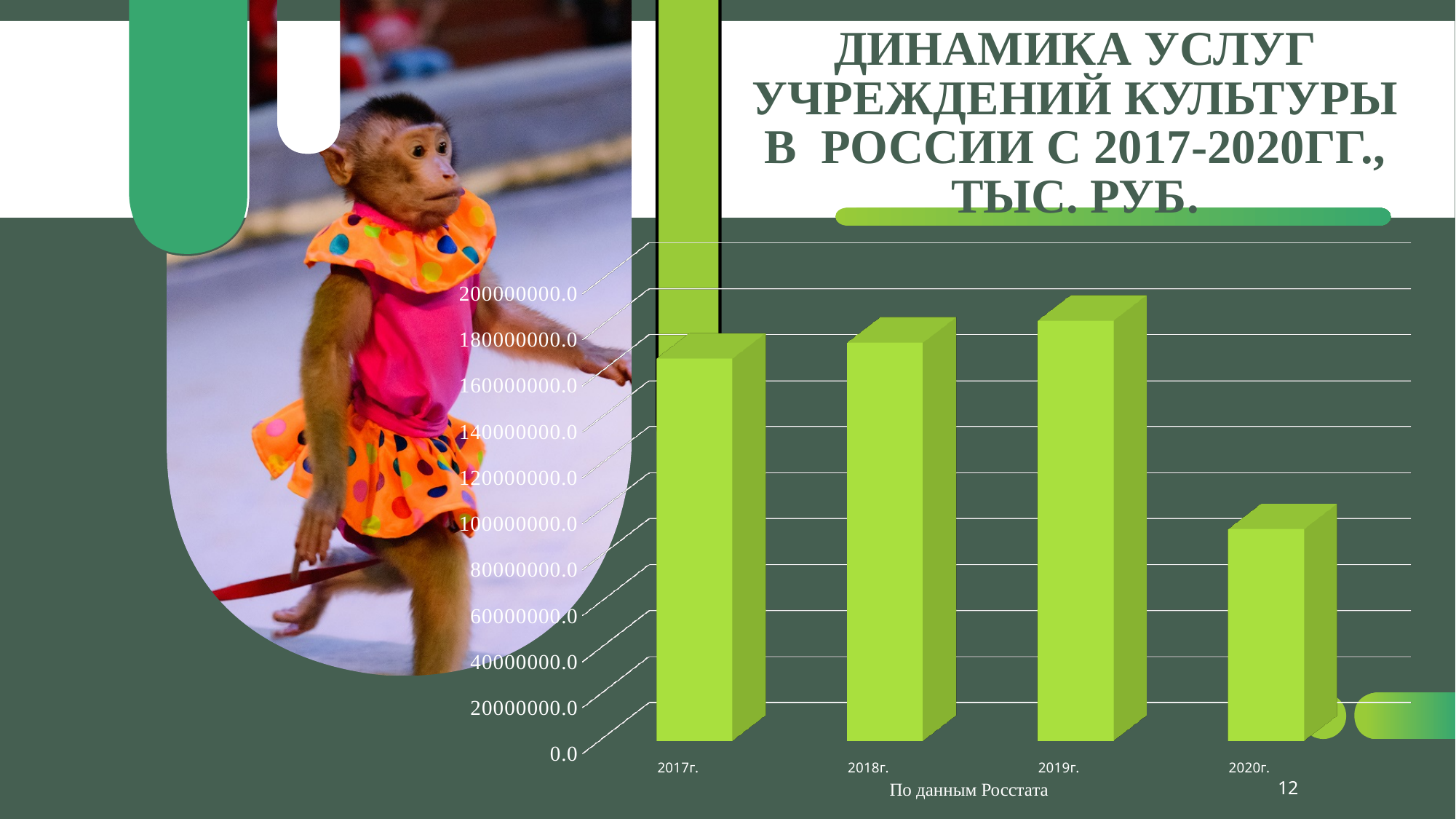
Which is larger, the value for 2018г. or the value for 2020г.? 2018г. What kind of chart is shown on the slide? bar chart Which is larger, the value for 2017г. or the value for 2019г.? 2019г. Which year has the lowest value on the chart? 2020г. Is the value for 2020г. greater or less than 120000000.0? less Is the value for 2017г. greater or less than 160000000.0? greater How do the values change from 2017г. to 2020г.? They rise from 2017 to 2019, then fall sharply in 2020 Is the value for 2019г. greater or less than 160000000.0? greater What data source is cited below the chart? По данным Росстата Which year has the highest value on the chart? 2019г. How many years (categories) are plotted on the chart? 4